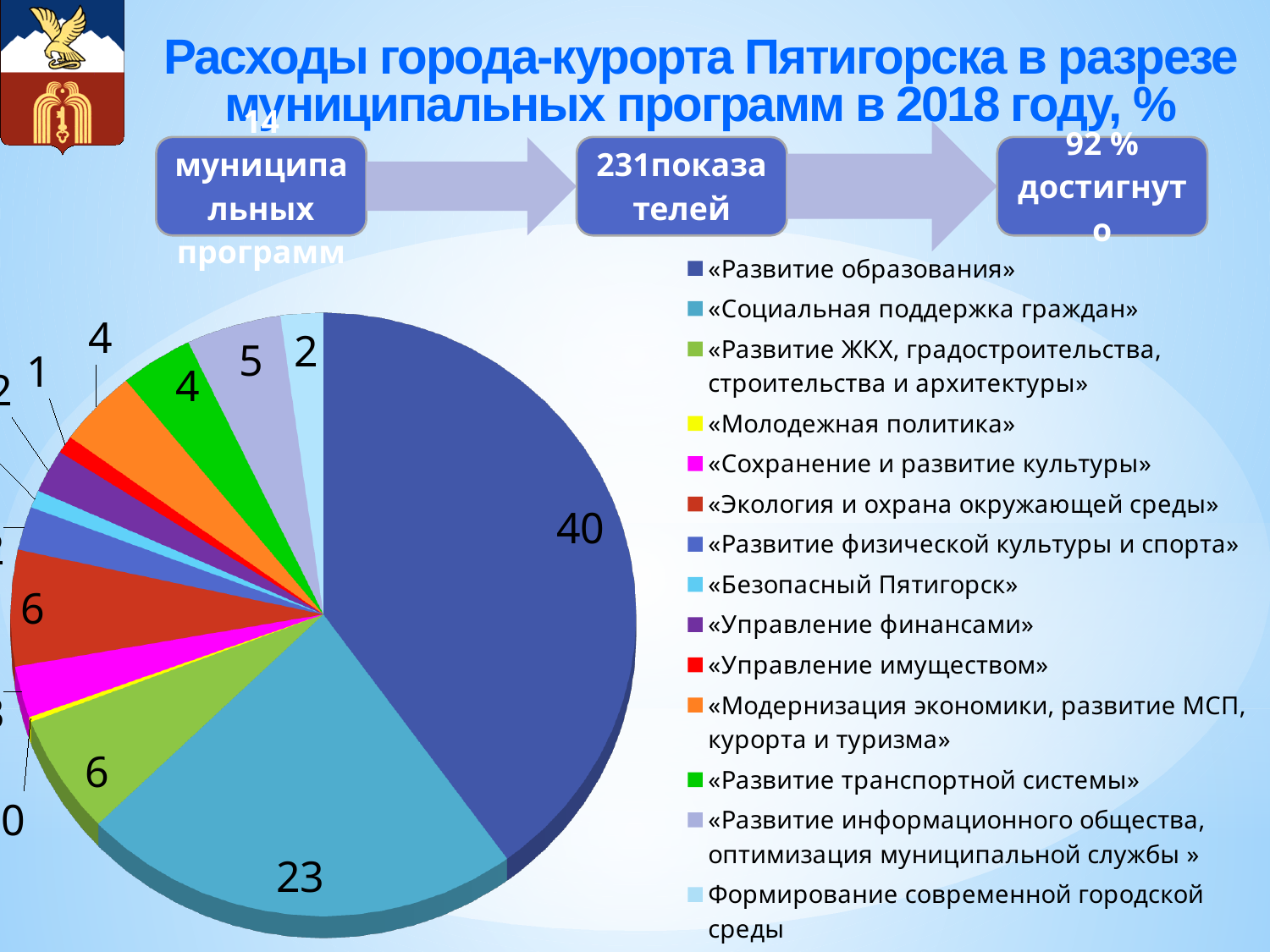
What kind of chart is shown on the slide? pie chart What value is shown for «Развитие образования»? 40 What is the difference between the values for «Развитие образования» and «Социальная поддержка граждан»? 17 What value is shown for «Социальная поддержка граждан»? 23 What value is shown for «Развитие транспортной системы»? 4 What value is shown for «Формирование современной городской среды»? 2 How many categories does the legend of the pie chart list? 14 What colour represents «Молодежная политика» in the legend? yellow What value is shown for «Развитие информационного общества, оптимизация муниципальной службы»? 5 Which is larger, the value for «Социальная поддержка граждан» or the value for «Экология и охрана окружающей среды»? «Социальная поддержка граждан» What is the title of the slide containing the pie chart? Расходы города-курорта Пятигорска в разрезе муниципальных программ в 2018 году, % Which category has the largest slice of the pie? «Развитие образования»